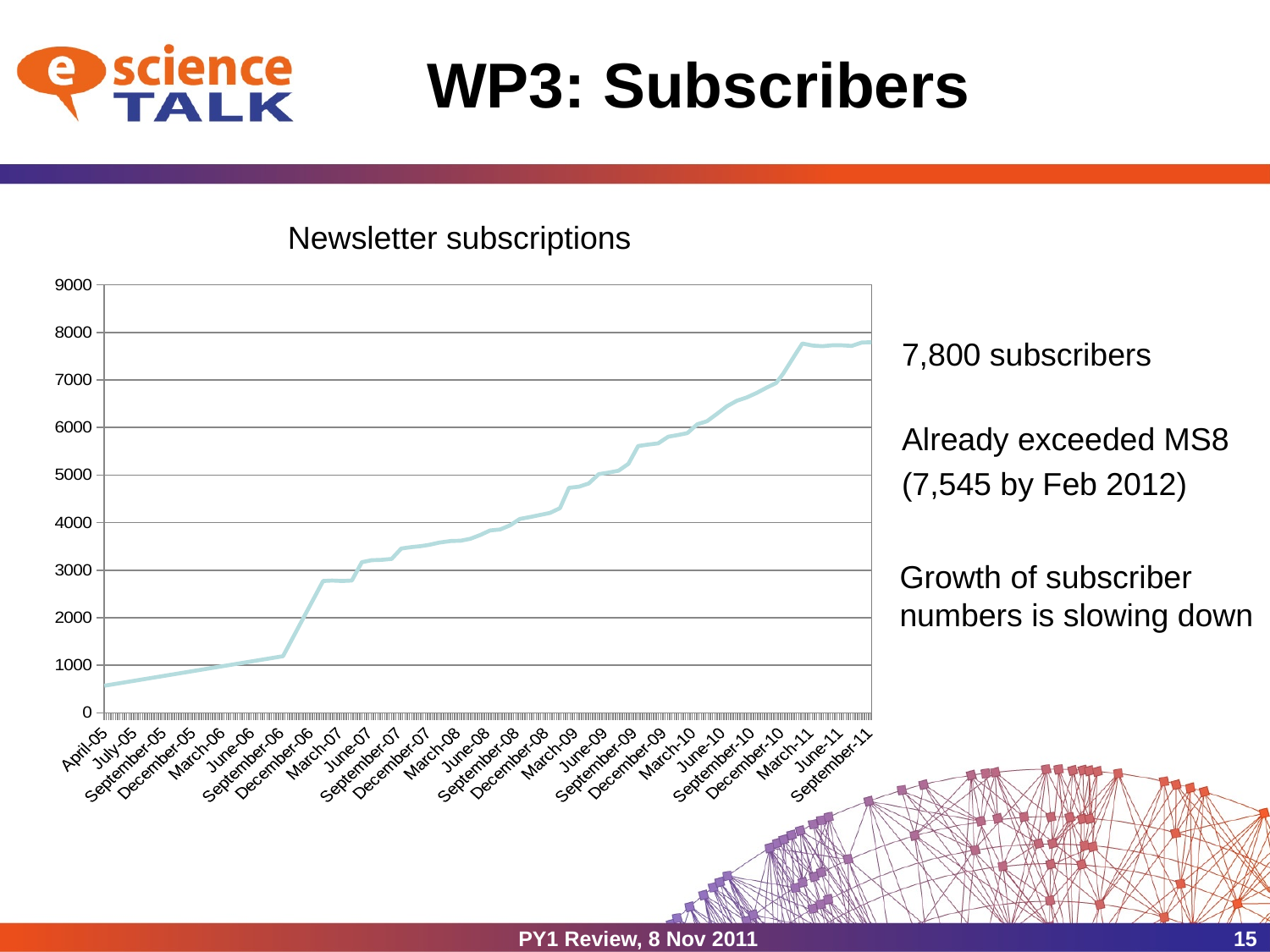
What kind of chart is shown on the slide? line chart Which point on the x axis has the lowest number of newsletter subscriptions? April-05 Which has more newsletter subscriptions, March-06 or March-07? March-07 What is the title of the chart? Newsletter subscriptions What is the highest value shown on the y axis of the chart? 9000 Is the value for September-11 greater or less than 7000? greater Is the value for September-08 greater or less than 5000? less Is the value for March-07 greater or less than 2000? greater Do the newsletter subscription values rise or fall from April-05 to September-11? rise